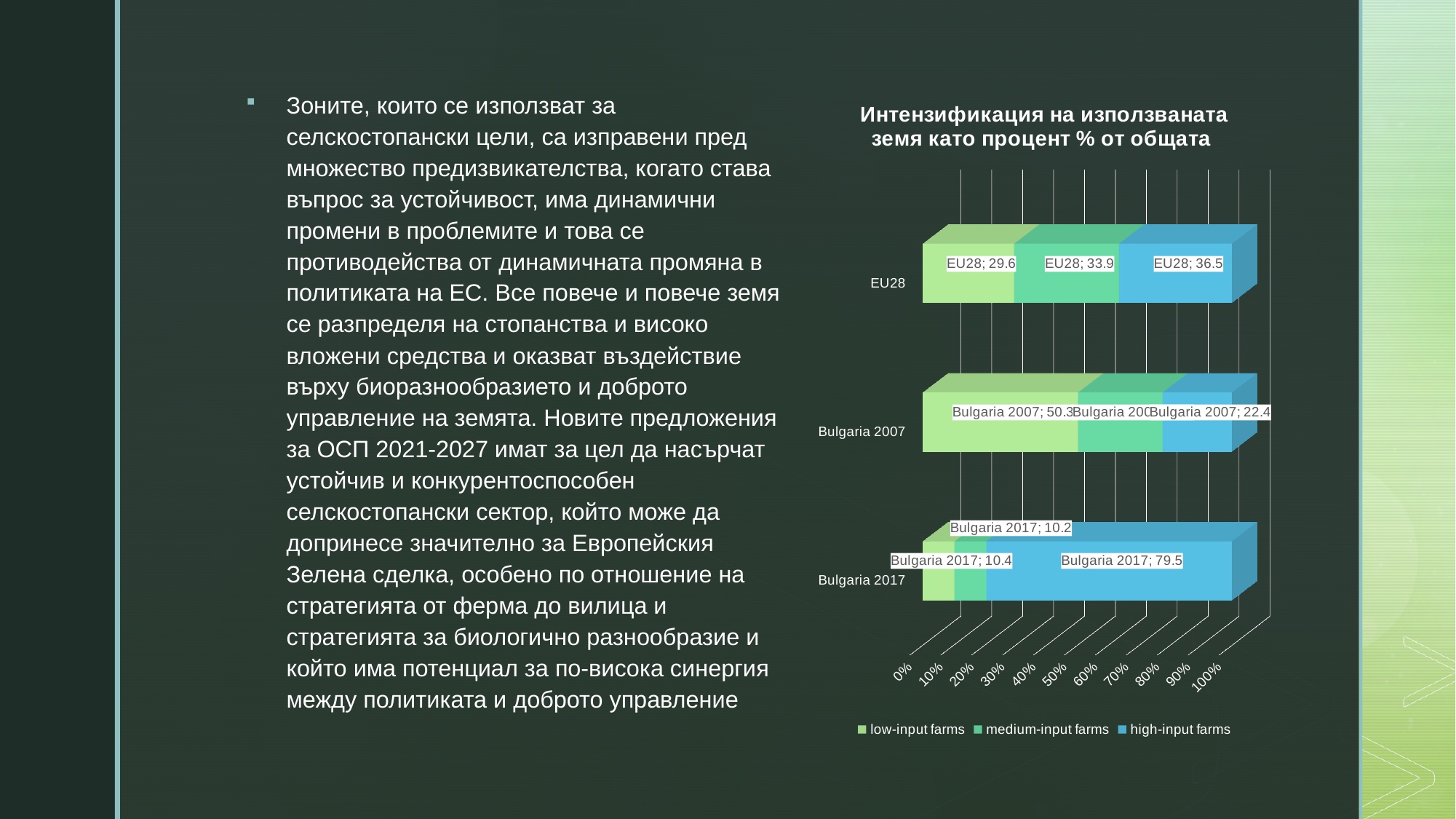
Which category has the lowest value for low-input farms? Bulgaria 2017 What kind of chart is shown on the slide? Stacked bar chart Which category has the highest value for high-input farms? Bulgaria 2017 What is the value for low-input farms for EU28? 29.6 What is the value for low-input farms for Bulgaria 2007? 50.3 For EU28, which is larger: the medium-input farms value or the low-input farms value? medium-input farms What is the value for medium-input farms for Bulgaria 2017? 10.2 What is the difference between the high-input farms and low-input farms values for Bulgaria 2017? 69.1 How many categories are shown on the chart? 3 What is the difference between the low-input farms and high-input farms values for Bulgaria 2007? 27.9 What is the value for high-input farms for Bulgaria 2017? 79.5 How many series does the legend list? 3